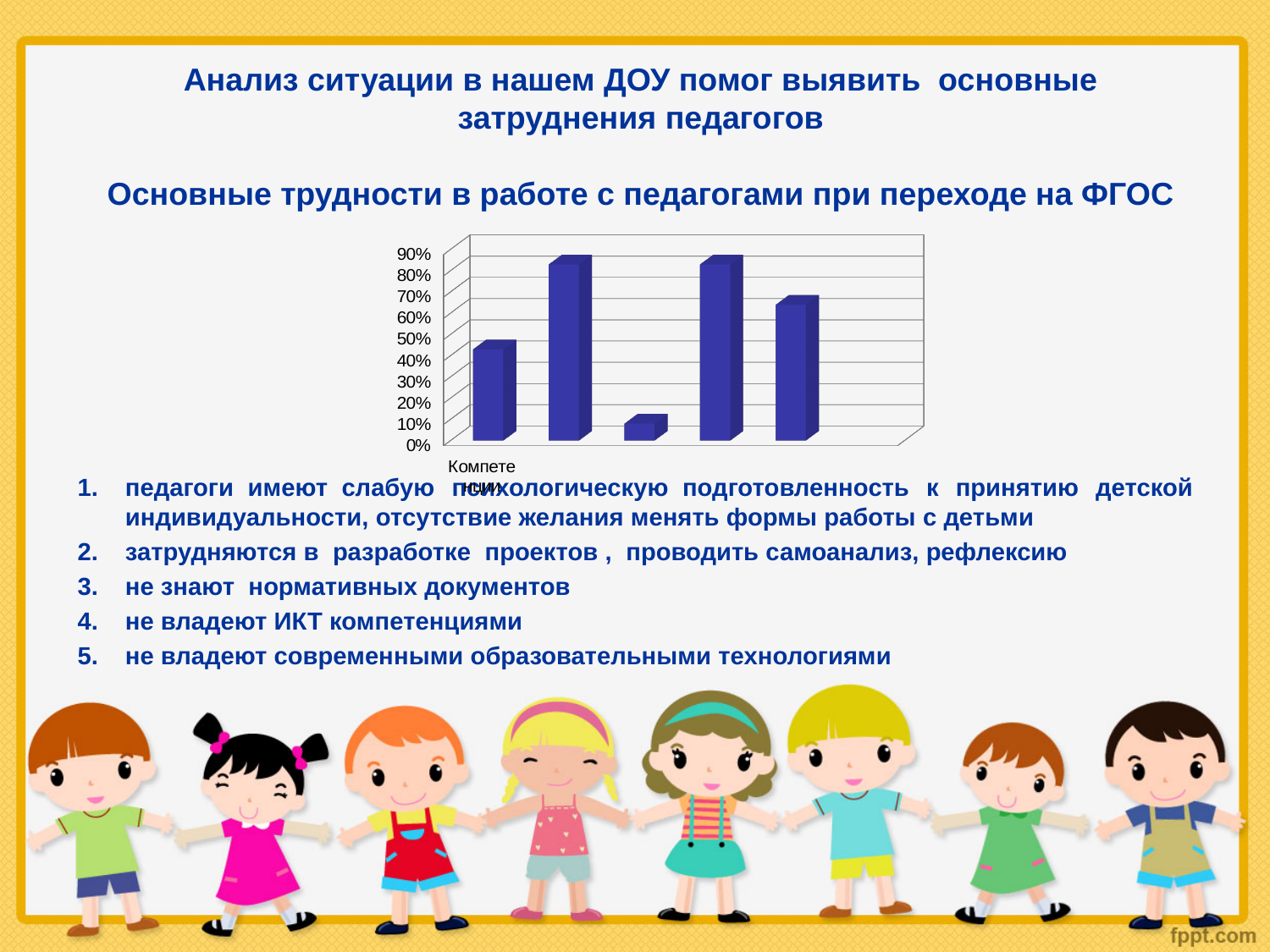
What kind of chart is shown on the slide? bar chart Is the value of the fourth bar greater or less than 60%? greater Is the value of the first (leftmost) bar greater or less than 30%? greater How many bars does the chart contain? 5 Is the value of the second bar greater or less than 70%? greater What is the title written above the chart? Основные трудности в работе с педагогами при переходе на ФГОС Which is larger, the first bar or the third bar? the first bar Which is larger, the first bar or the fifth bar? the fifth bar What is the highest tick value shown on the vertical axis of the chart? 90% Which bar in the chart is the lowest? the third bar